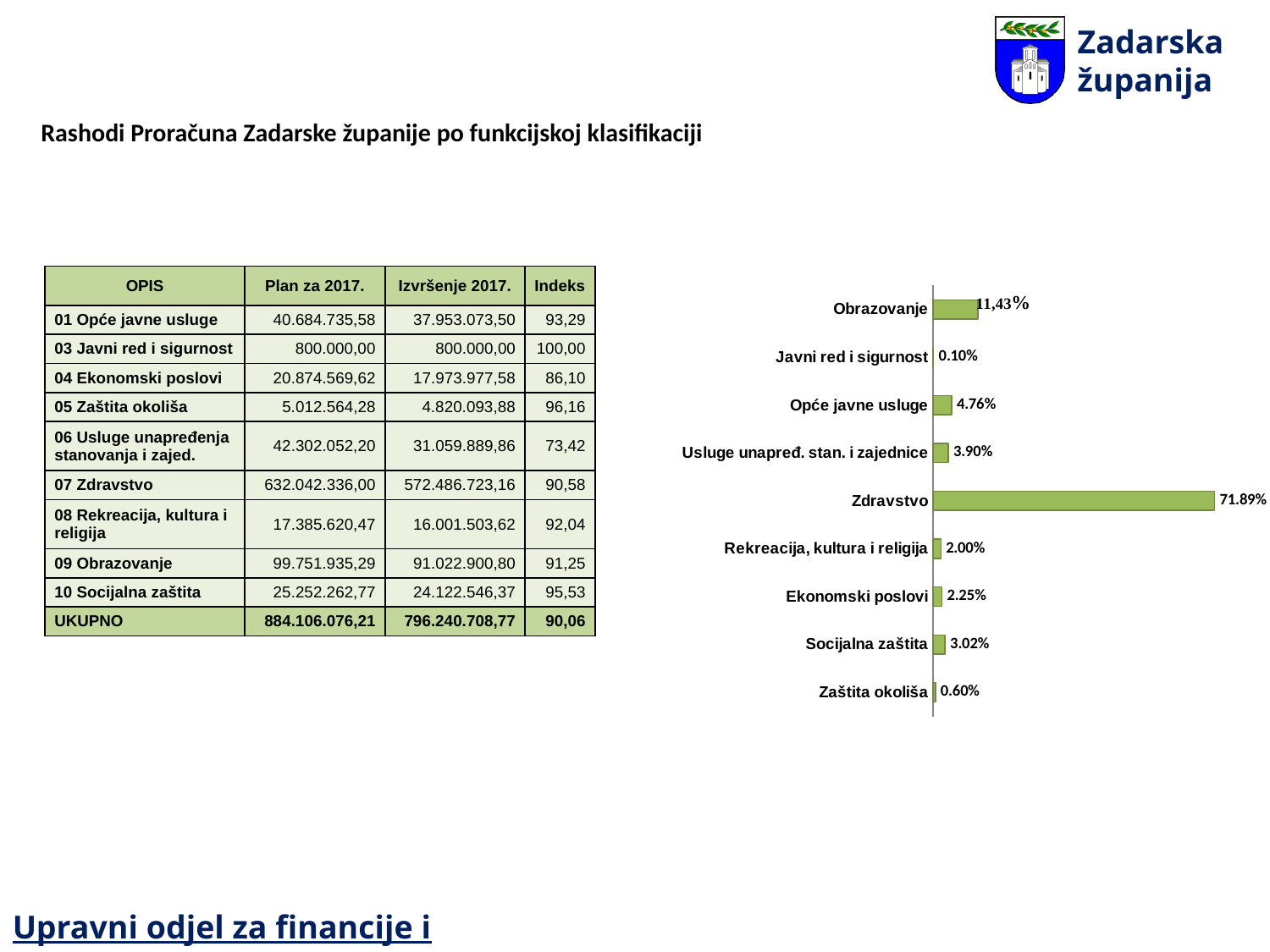
What is the value shown for Zdravstvo in the bar chart? 71.89% What is the difference between the values for Opće javne usluge and Usluge unapređ. stan. i zajednice in the bar chart? 0.86% What is the value shown for Opće javne usluge in the bar chart? 4.76% What is the difference between the values for Ekonomski poslovi and Rekreacija, kultura i religija in the bar chart? 0.25% Which category has the highest value in the bar chart? Zdravstvo In the bar chart, which is larger: Ekonomski poslovi or Socijalna zaštita? Socijalna zaštita What is the value shown for Javni red i sigurnost in the bar chart? 0.10% What kind of chart is shown on the right of the slide? bar chart Which category has the lowest value in the bar chart? Javni red i sigurnost What is the value shown for Socijalna zaštita in the bar chart? 3.02% How many categories does the bar chart show? 9 What is the value shown for Obrazovanje in the bar chart? 11,43%